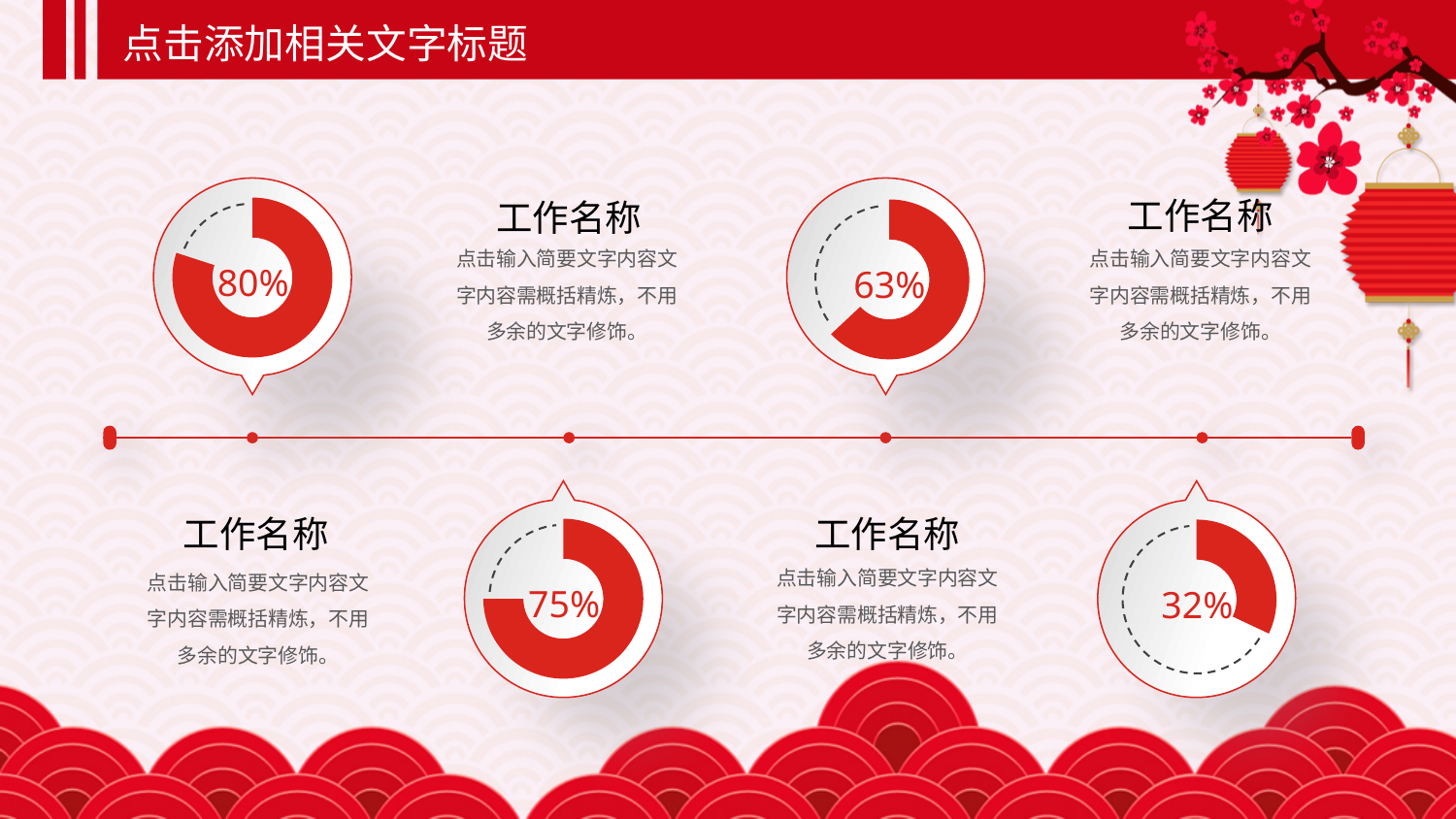
What is the difference between the percentage in the top-left chart and the percentage in the bottom-right chart? 48% How many circular percentage charts are on the slide? 4 What percentage is shown in the top-right circular chart? 63% What percentage is shown in the bottom-left circular chart (the one in the lower middle-left of the slide)? 75% What kind of chart is used to display each percentage on the slide? Circular progress (donut) chart What colour is the filled portion of each circular chart? Red Which of the four circular charts shows the lowest percentage? The bottom-right chart (32%) What is the difference between the percentage in the bottom-left chart and the percentage in the top-right chart? 12% What percentage is shown in the top-left circular chart? 80% Which is larger, the percentage in the top-right chart or the percentage in the bottom-left chart? The bottom-left chart (75%) What percentage is shown in the bottom-right circular chart? 32% Which of the four circular charts shows the highest percentage? The top-left chart (80%)